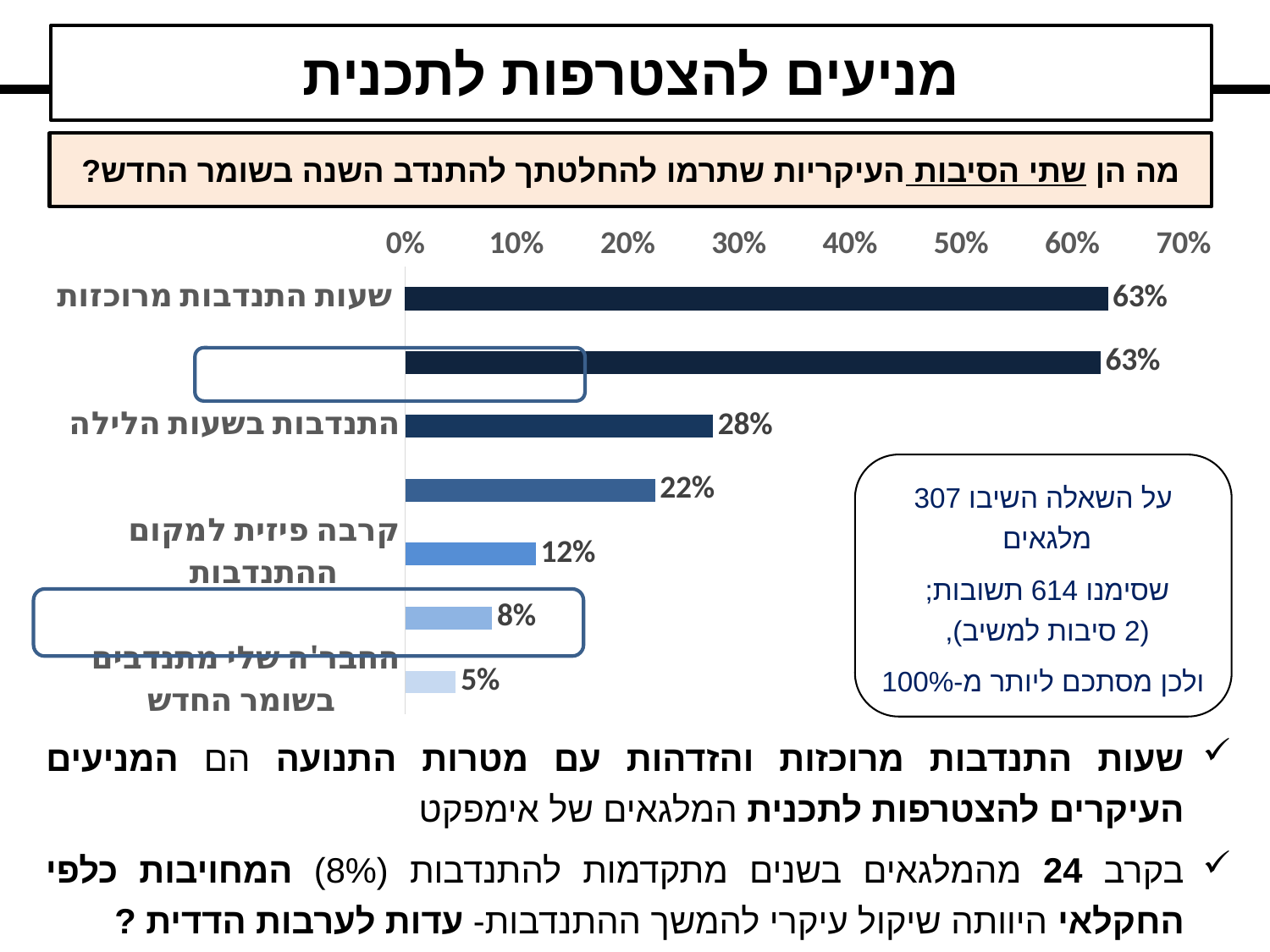
What is the difference between the values for "שעות התנדבות מרוכזות" and "התנדבות בשעות הלילה"? 35 percentage points What kind of chart is shown on the slide? bar chart What is the difference between the values for "קרבה פיזית למקום ההתנדבות" and "החבר'ה שלי מתנדבים בשומר החדש"? 7 percentage points What is the value for "קרבה פיזית למקום ההתנדבות"? 12% How many bars are plotted on the chart? 7 What is the value for "התנדבות בשעות הלילה"? 28% What is the value for "שעות התנדבות מרוכזות"? 63% What is the highest value shown on the chart? 63% Is the value for "התנדבות בשעות הלילה" greater or less than 30%? less What is the value for "החבר'ה שלי מתנדבים בשומר החדש"? 5% Which category has the lowest value? החבר'ה שלי מתנדבים בשומר החדש Which is larger: the value for "התנדבות בשעות הלילה" or for "קרבה פיזית למקום ההתנדבות"? התנדבות בשעות הלילה